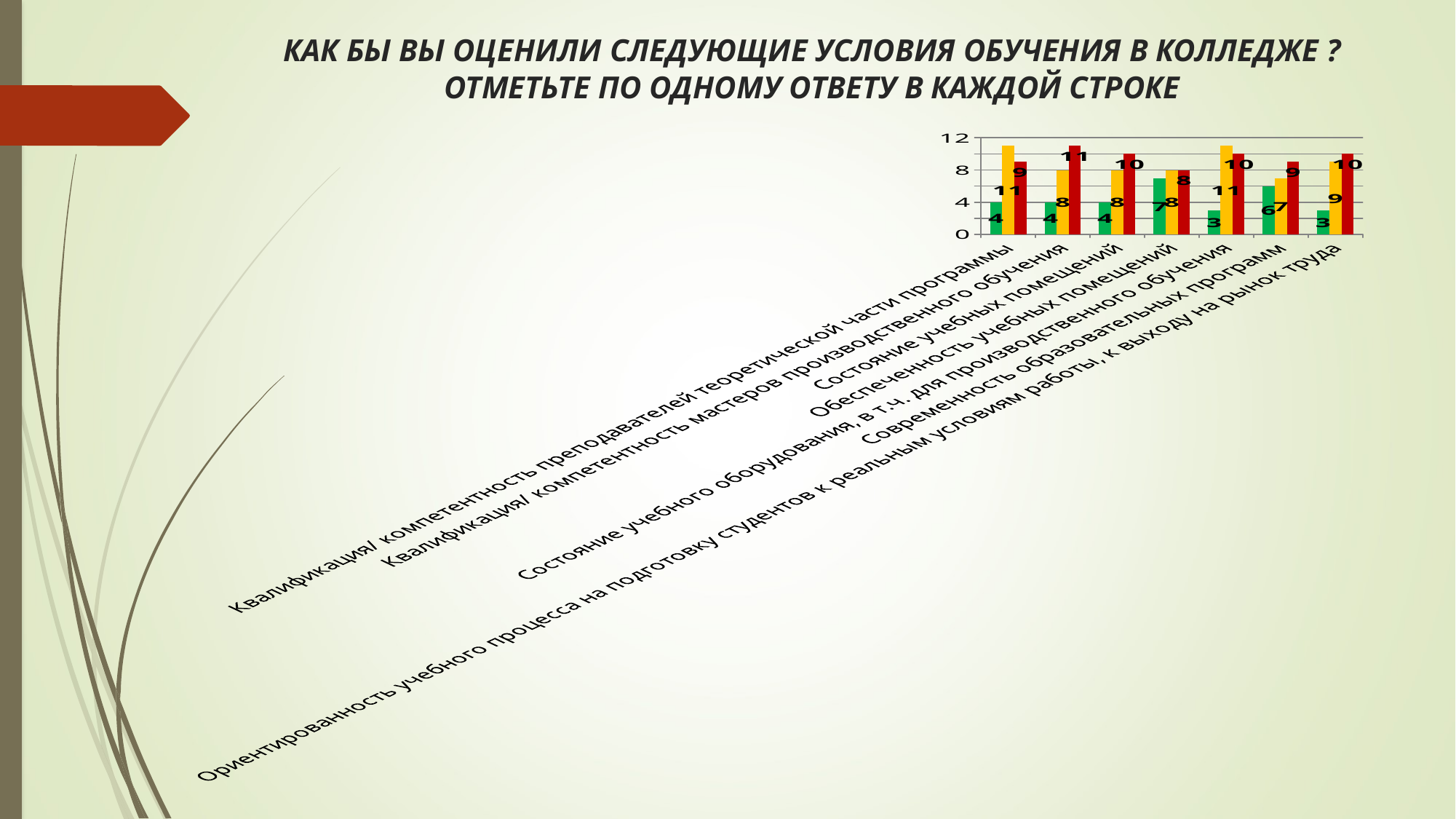
What is the difference between the yellow bar and the green bar for 'Состояние учебного оборудования, в т.ч. для производственного обучения'? 8 What is the value of the red bar for 'Состояние учебных помещений'? 10 What is the value of the red bar for 'Квалификация/ компетентность мастеров производственного обучения'? 11 What is the value of the green bar for 'Современность образовательных программ'? 6 How many categories are shown on the x axis of the chart? 7 What kind of chart is shown on the slide? bar chart Which category has the lowest green bar value? Состояние учебного оборудования, в т.ч. для производственного обучения (tied with Ориентированность учебного процесса...), both 3 What is the value of the green bar for 'Обеспеченность учебных помещений'? 7 Which is larger for 'Ориентированность учебного процесса на подготовку студентов к реальным условиям работы, к выходу на рынок труда': the yellow bar or the red bar? the red bar What is the value of the yellow bar for 'Квалификация/ компетентность преподавателей теоретической части программы'? 11 Is the value of the red bar for 'Современность образовательных программ' greater or less than 8? greater What is the highest value shown on the vertical axis of the chart? 12